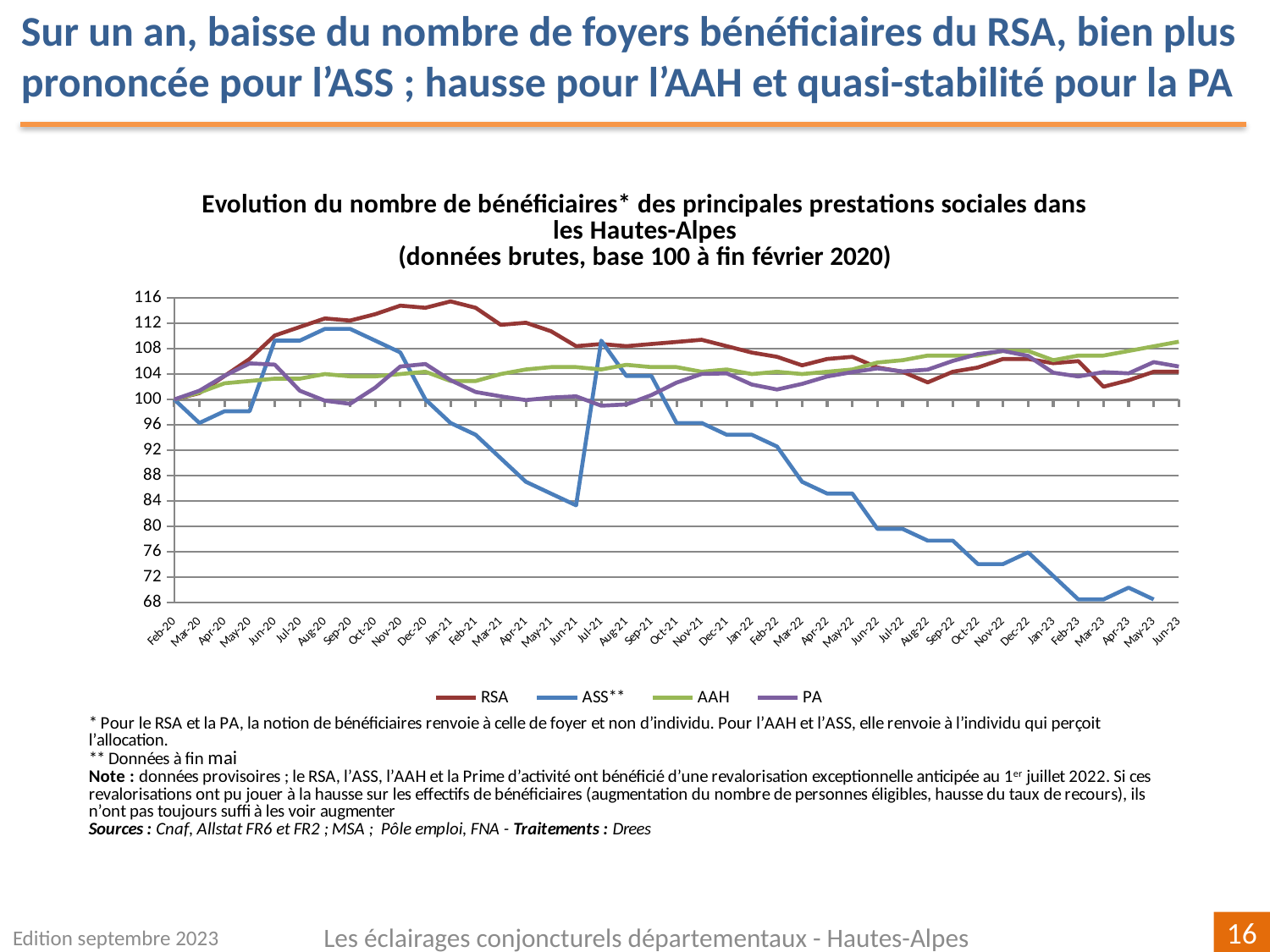
In Jun-23, which is larger, the value for AAH or the value for RSA? AAH Which series has the lowest value in Jun-23? RSA Is the value for AAH in Jun-23 greater or less than 108? greater Is the value for ASS** in Mar-20 greater or less than 100? less What kind of chart is shown on the slide? line chart Which series has the highest value in Jan-21? RSA Does the ASS** series overall rise or fall between Feb-20 and Jun-23? fall Is the value for RSA in Jan-21 greater or less than 112? greater How many series does the legend list? 4 Which series are listed in the legend? RSA, ASS**, AAH, PA How many monthly points are plotted along the x axis, from Feb-20 to Jun-23? 41